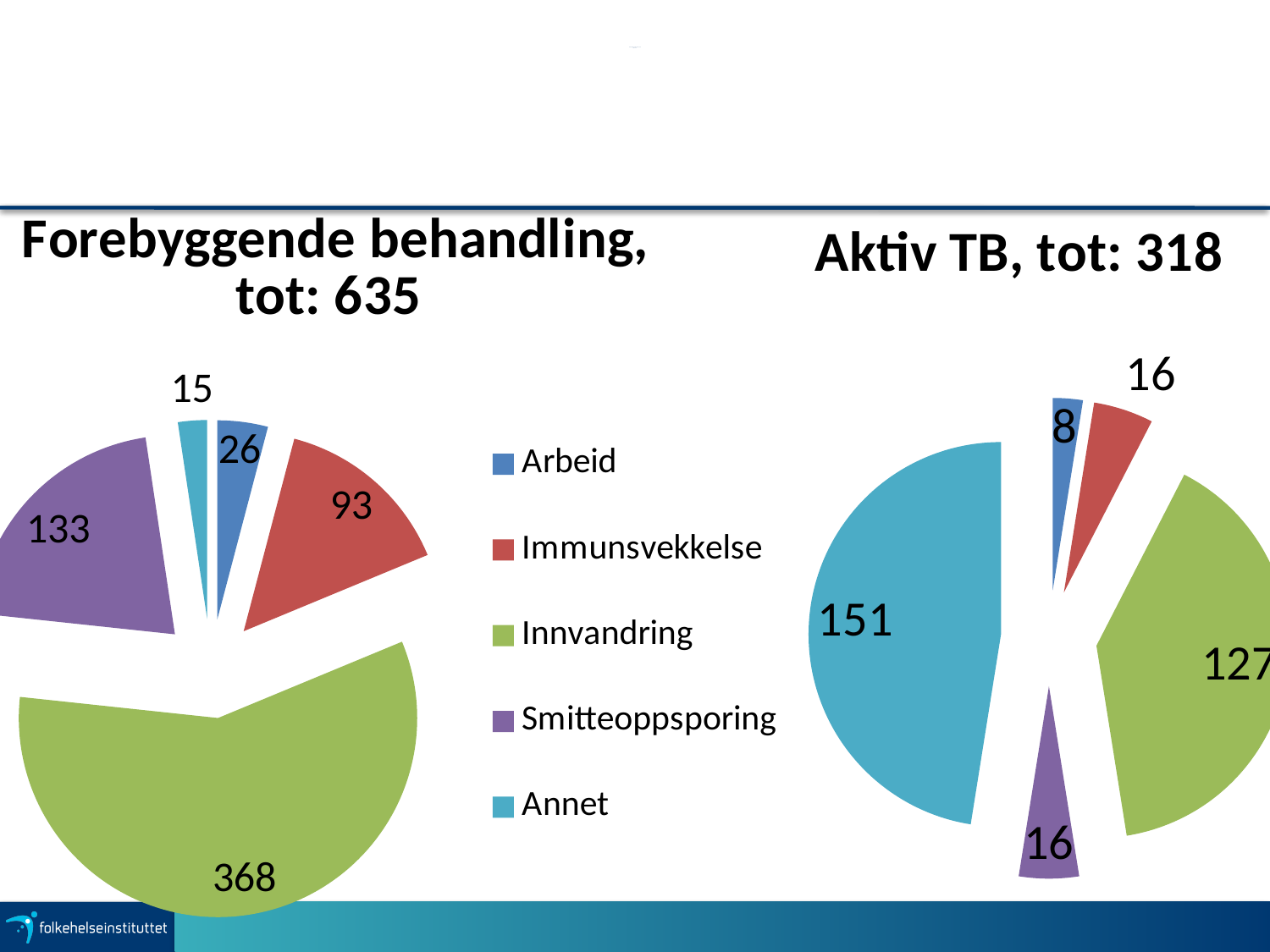
In the 'Forebyggende behandling, tot: 635' pie chart, what is the value for Innvandring? 368 In the 'Aktiv TB, tot: 318' pie chart, what is the value for Annet? 151 In the 'Aktiv TB, tot: 318' pie chart, what is the value for Arbeid? 8 In the 'Forebyggende behandling, tot: 635' pie chart, which is larger, Immunsvekkelse or Smitteoppsporing? Smitteoppsporing What kind of chart is the 'Aktiv TB, tot: 318' chart? Pie chart In the 'Forebyggende behandling, tot: 635' pie chart, which category has the largest slice? Innvandring In the 'Aktiv TB, tot: 318' pie chart, which category has the largest slice? Annet How many categories does the legend list? 5 In the 'Aktiv TB, tot: 318' pie chart, what is the difference between the values for Annet and Innvandring? 24 In the 'Forebyggende behandling, tot: 635' pie chart, what is the value for Smitteoppsporing? 133 In the 'Forebyggende behandling, tot: 635' pie chart, which category has the smallest slice? Annet In the 'Forebyggende behandling, tot: 635' pie chart, what is the difference between the values for Innvandring and Smitteoppsporing? 235